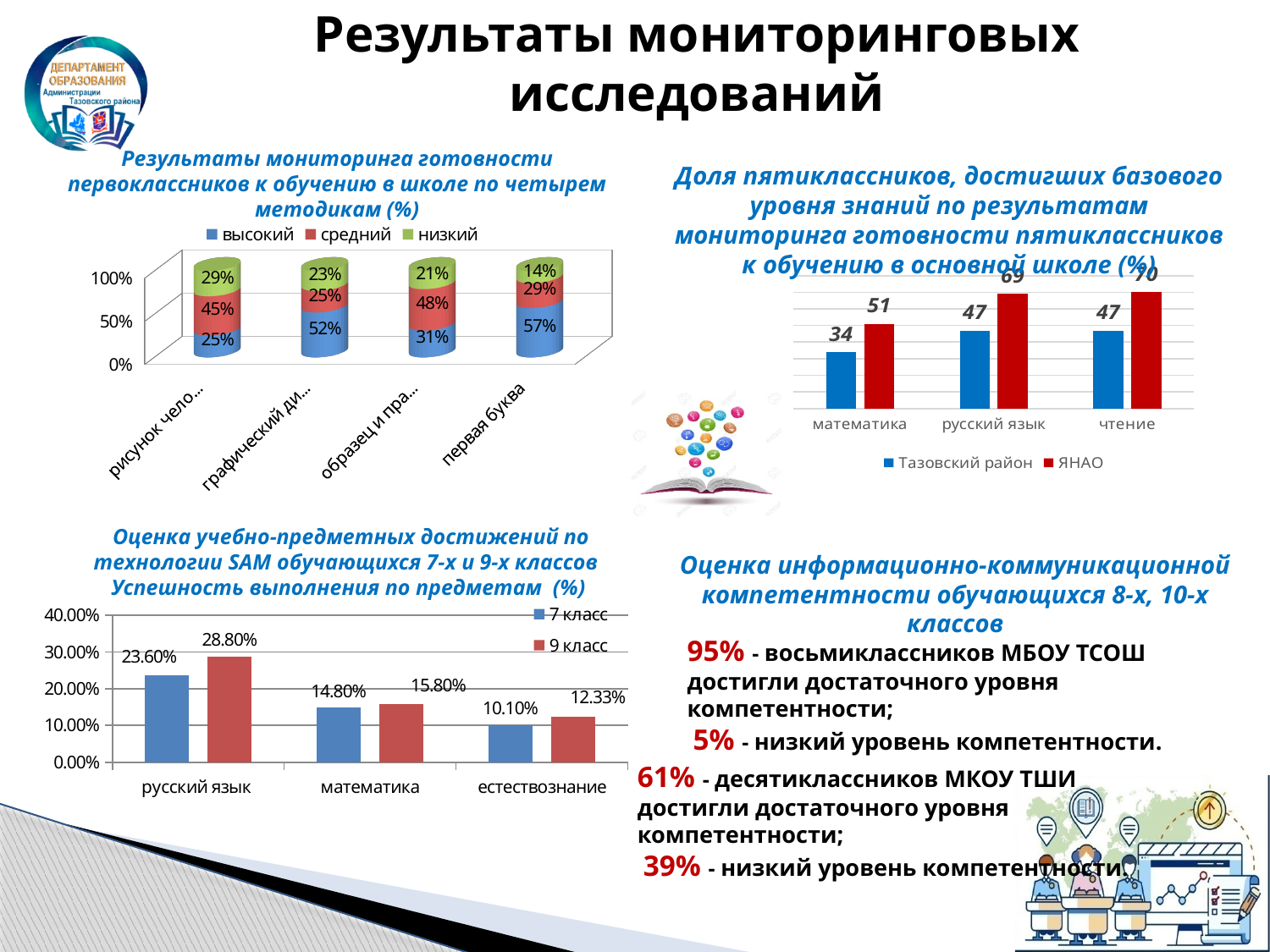
In the SAM assessment chart (bottom left), which is larger in математика: 7 класс or 9 класс? 9 класс In the first-graders readiness chart (top left), what kind of chart is it? stacked bar chart In the first-graders readiness chart (top left), what is the value of the высокий series for первая буква? 57% In the SAM assessment chart (bottom left), what is the value for 9 класс in русский язык? 28.80% In the SAM assessment chart (bottom left), what is the value for 7 класс in естествознание? 10.10% In the chart about fifth-graders reaching the basic level (top right), which subject has the lowest value for Тазовский район? математика In the chart about fifth-graders reaching the basic level (top right), what is the value for Тазовский район in математика? 34 In the SAM assessment chart (bottom left), how many subject categories are shown on the x axis? 3 In the chart about fifth-graders reaching the basic level (top right), what is the difference between ЯНАО and Тазовский район for русский язык? 22 In the SAM assessment chart (bottom left), which subject has the highest value for 7 класс? русский язык In the chart about fifth-graders reaching the basic level (top right), how many series does the legend list? 2 In the chart about fifth-graders reaching the basic level (top right), what is the value for ЯНАО in чтение? 70